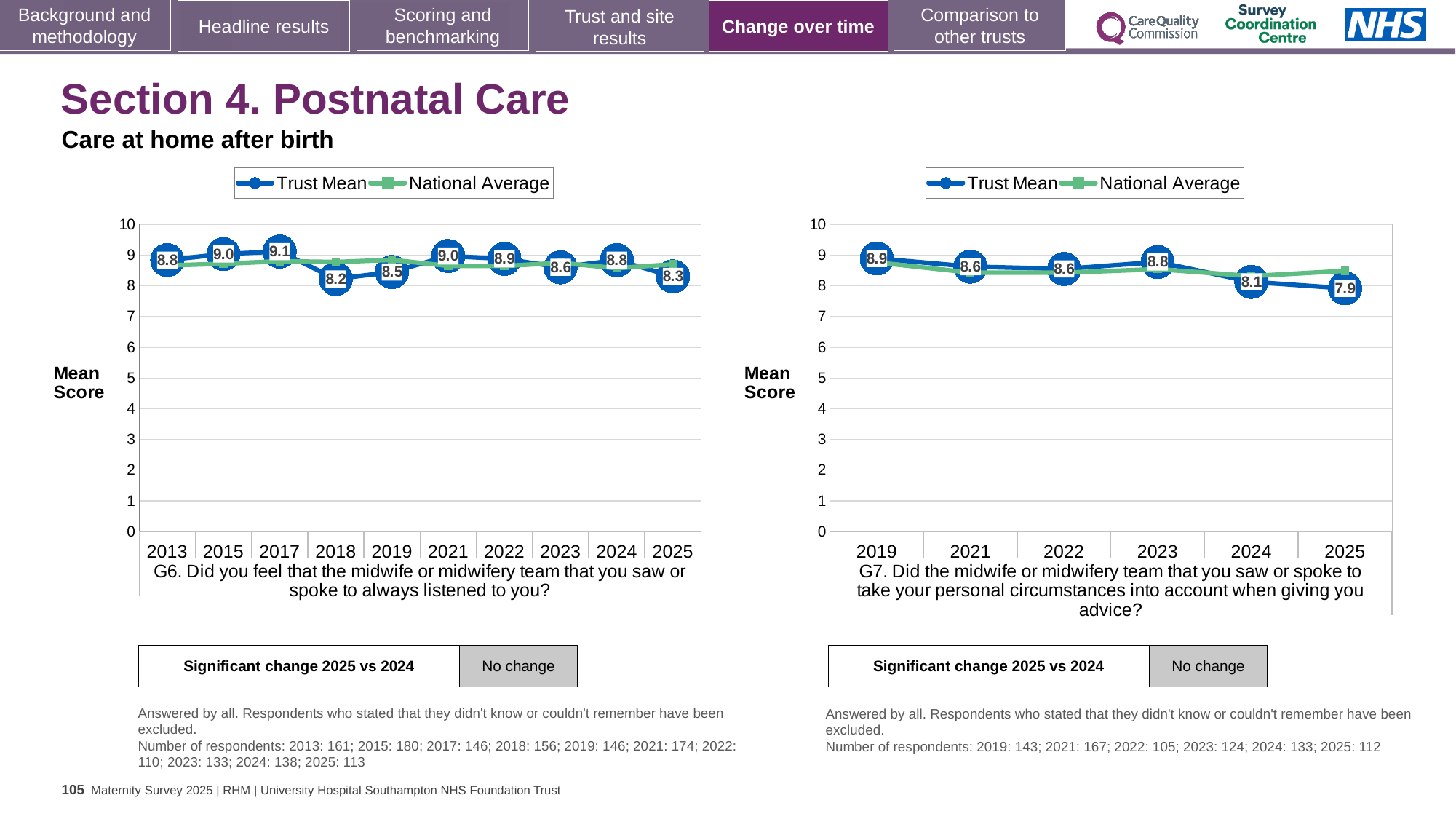
In the right chart (G7), what is the Trust Mean score for 2025? 7.9 In the right chart (G7), which year has the lowest Trust Mean score? 2025 In the left chart (G6), how many years are shown on the x axis? 10 In the right chart (G7), does the Trust Mean score rise or fall from 2023 to 2025? fall In the left chart (G6), what is the Trust Mean score for 2025? 8.3 How many series does the legend of the right chart (G7) list? 2 In the left chart (G6), what is the Trust Mean score for 2017? 9.1 In the left chart (G6), which year has the lowest Trust Mean score? 2018 In the right chart (G7), what is the Trust Mean score for 2023? 8.8 In the left chart (G6), which year has the highest Trust Mean score? 2017 In the right chart (G7), is the Trust Mean score for 2019 or 2024 larger? 2019 In the left chart (G6), what is the difference between the Trust Mean scores for 2024 and 2025? 0.5